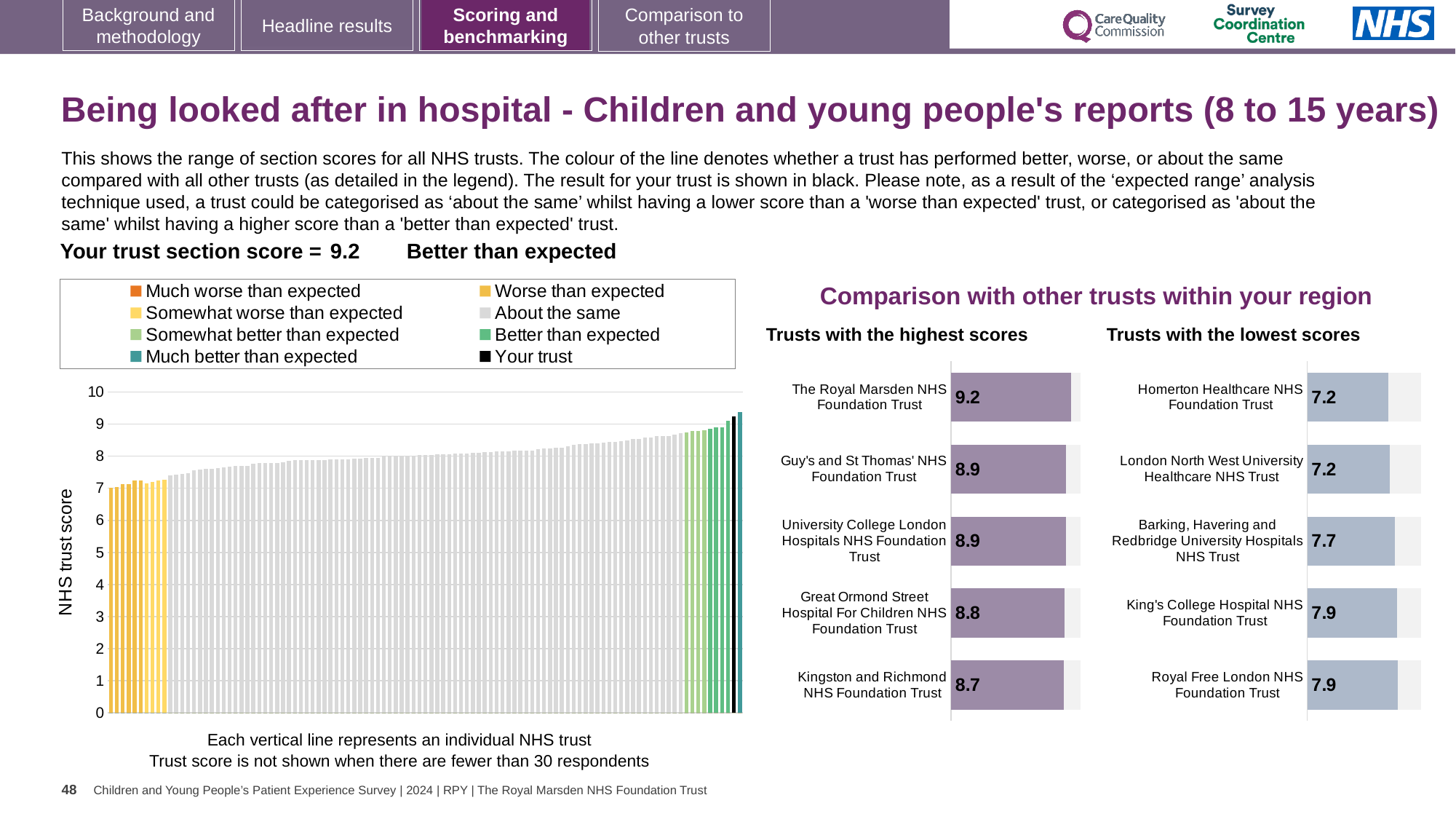
In the 'Trusts with the lowest scores' chart, what is the difference between the scores of Royal Free London NHS Foundation Trust and Homerton Healthcare NHS Foundation Trust? 0.7 In the 'Trusts with the highest scores' chart, what is the score for Great Ormond Street Hospital For Children NHS Foundation Trust? 8.8 In the large chart on the left, is the value of the leftmost bar greater or less than 8? less In the 'Trusts with the highest scores' chart, what is the difference between the scores of The Royal Marsden NHS Foundation Trust and Kingston and Richmond NHS Foundation Trust? 0.5 How many trusts are shown in the 'Trusts with the highest scores' chart? 5 How many entries does the legend above the large chart on the left list? 8 In the 'Trusts with the highest scores' chart, which trust has the highest score? The Royal Marsden NHS Foundation Trust How many trusts are shown in the 'Trusts with the lowest scores' chart? 5 In the large chart on the left showing NHS trust scores, do the values rise or fall from left to right? rise In the 'Trusts with the lowest scores' chart, what is the score for Barking, Havering and Redbridge University Hospitals NHS Trust? 7.7 In the 'Trusts with the highest scores' chart, which has the larger score: Great Ormond Street Hospital For Children NHS Foundation Trust or Kingston and Richmond NHS Foundation Trust? Great Ormond Street Hospital For Children NHS Foundation Trust What kind of chart is the large chart on the left showing NHS trust scores? bar chart